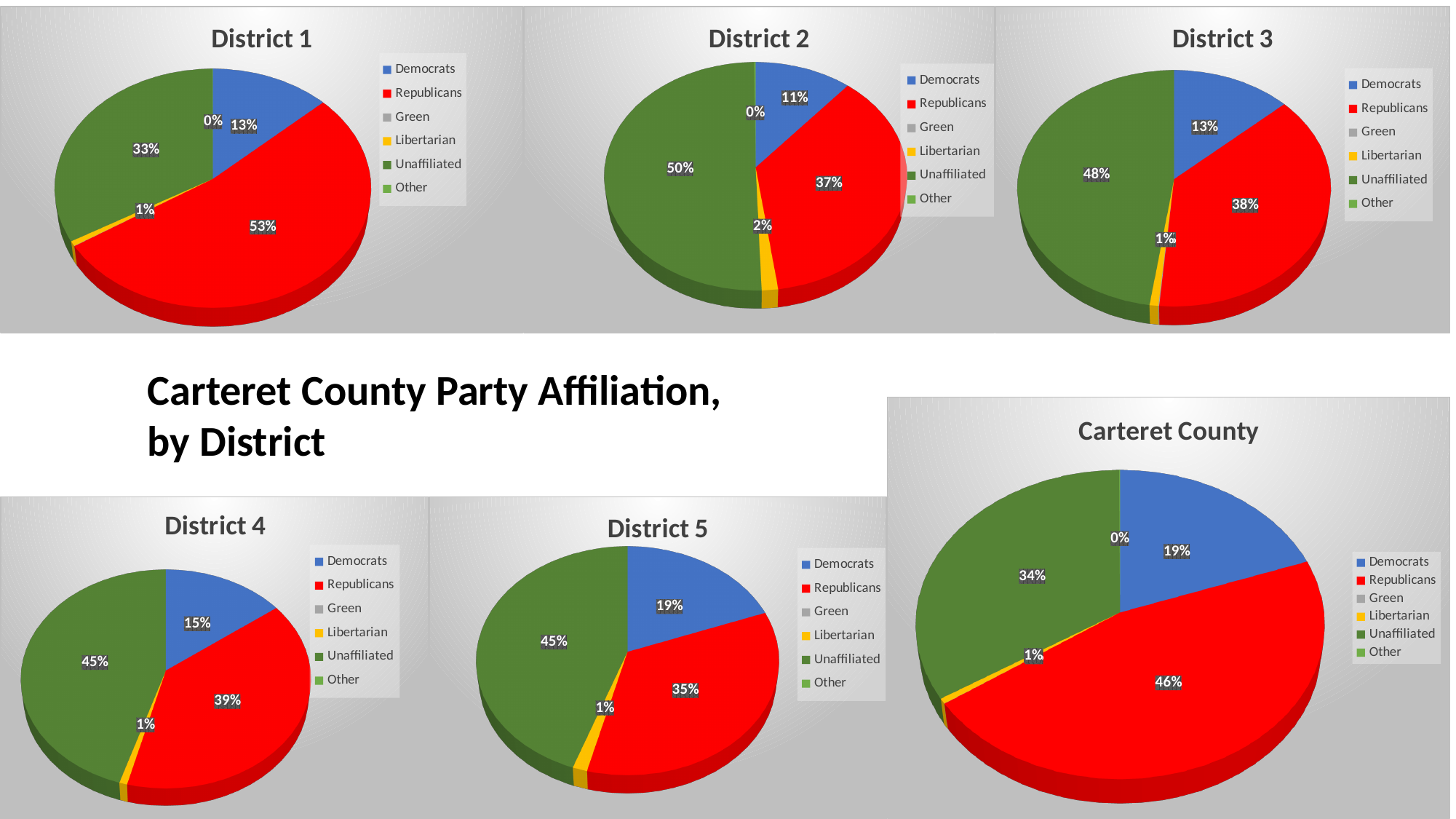
In the District 5 chart, what colour represents Unaffiliated? Green In the District 2 chart, which is larger, the Republicans slice or the Democrats slice? Republicans In the District 1 chart, what share of the pie is Republicans? 53% How many entries does the legend of the District 3 chart list? 6 In the District 4 chart, what share of the pie is Libertarian? 1% In the District 5 chart, which party has the largest slice? Unaffiliated What kind of chart is the Carteret County chart? Pie chart In the District 1 chart, which party has the largest slice? Republicans In the District 3 chart, what share of the pie is Democrats? 13% In the District 2 chart, what share of the pie is Unaffiliated? 50% In the Carteret County chart, what share of the pie is Republicans? 46% In the District 4 chart, what is the difference between the Unaffiliated share and the Republicans share? 6%